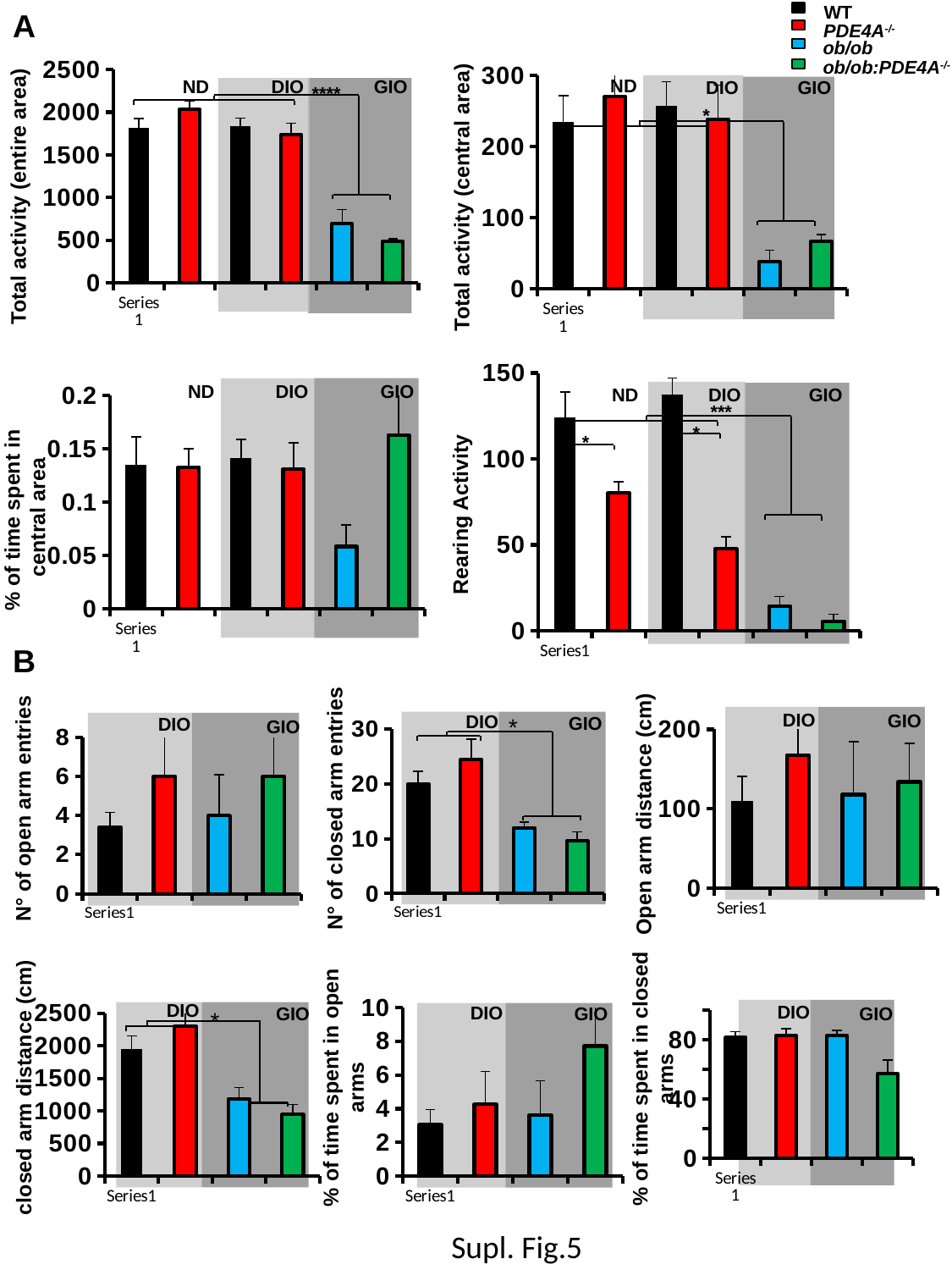
According to the legend, what colour are the ob/ob bars? blue In the '% of time spent in open arms' chart, which bar is the highest? ob/ob:PDE4A-/- In the 'Total activity (entire area)' chart, how many bars are plotted? 6 In the 'closed arm distance (cm)' chart, is the value for the WT bar greater or less than 1500? greater In the 'Rearing Activity' chart, which bar is the lowest? ob/ob:PDE4A-/- What kind of chart is the 'Rearing Activity' chart? bar chart In the 'N° of closed arm entries' chart, which is larger, the WT bar or the ob/ob bar? WT How many entries does the legend at the top right of the slide list? 4 In the 'Rearing Activity' chart, which bar is the highest? WT in the DIO group In the 'Total activity (entire area)' chart, is the value for the WT bar in the ND group greater or less than 1500? greater In the 'Total activity (central area)' chart, is the value for the ob/ob bar greater or less than 100? less